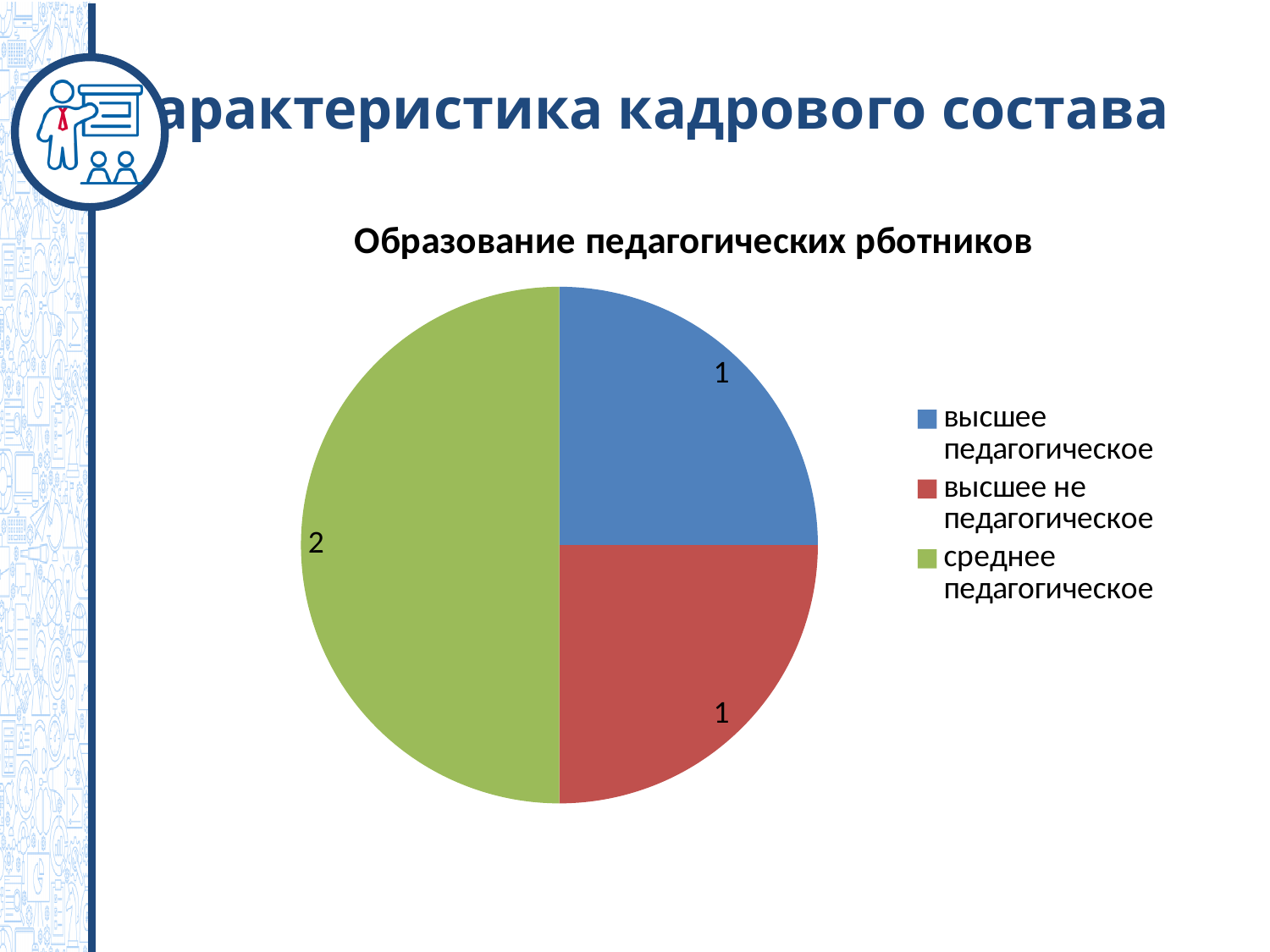
What is the title of the chart? Образование педагогических рботников How many slices does the pie chart have? 3 What type of chart is shown on the slide? pie chart What is the value for "высшее не педагогическое"? 1 What is the value for "среднее педагогическое"? 2 What share of the pie does "среднее педагогическое" represent? 50% What is the difference between the values for "среднее педагогическое" and "высшее не педагогическое"? 1 How many entries does the legend list? 3 What is the total of all slices in the pie chart? 4 What is the value for "высшее педагогическое"? 1 Which is larger, "среднее педагогическое" or "высшее педагогическое"? среднее педагогическое Which category has the largest slice of the pie? среднее педагогическое